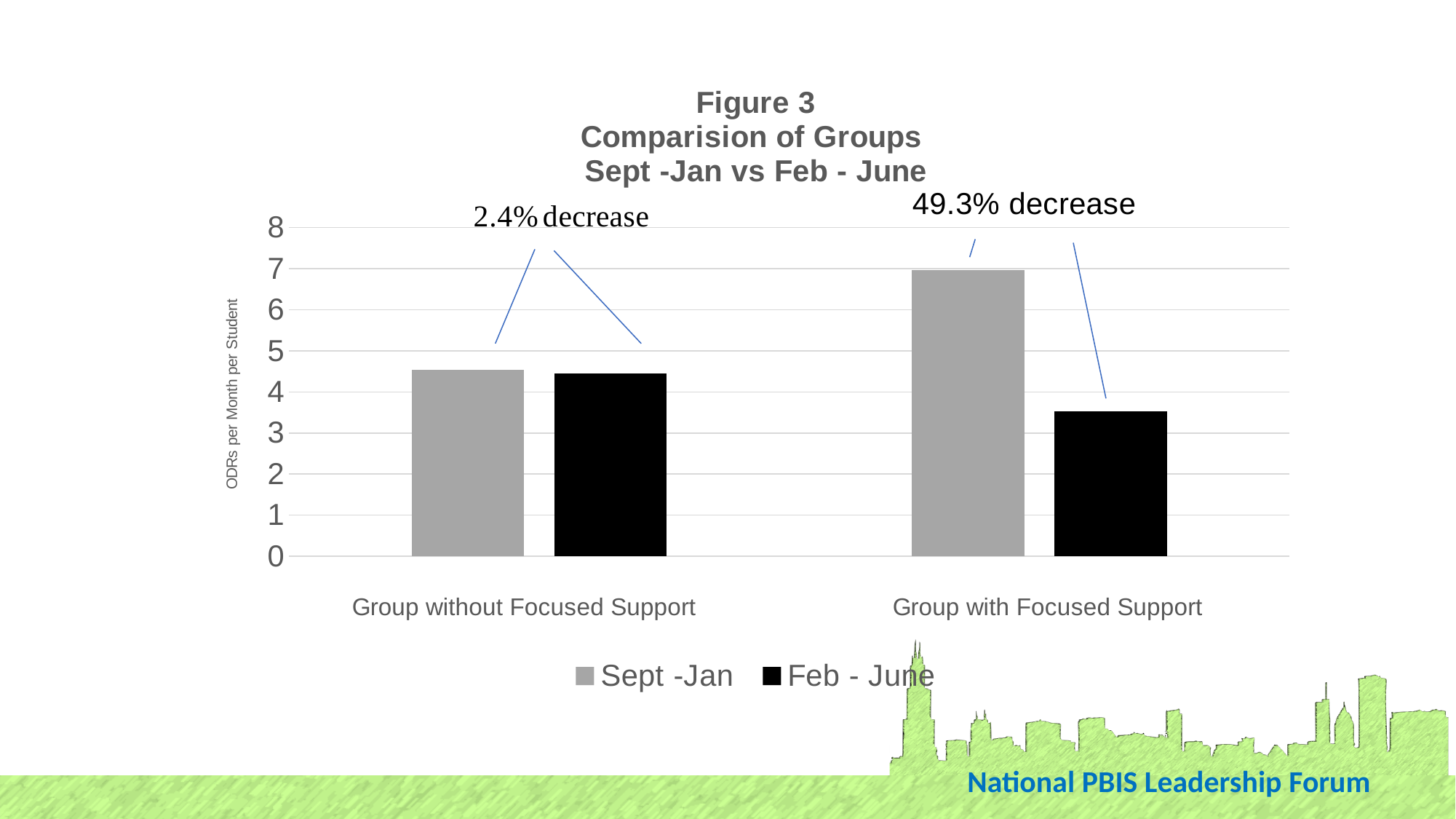
What percentage decrease is annotated for Group with Focused Support? 49.3% decrease What is the label on the y axis of the chart? ODRs per Month per Student Is the Sept -Jan value for Group with Focused Support greater or less than 6? greater Is the Sept -Jan value for Group without Focused Support greater or less than 5? less What kind of chart is shown on the slide? bar chart How many series does the legend list? 2 How many groups (categories) are shown on the x axis? 2 For the Feb - June series, which group has the larger value: Group without Focused Support or Group with Focused Support? Group without Focused Support For the Sept -Jan series, which group has the larger value: Group without Focused Support or Group with Focused Support? Group with Focused Support Which bar is the highest in the chart? Sept -Jan for Group with Focused Support Which bar is the lowest in the chart? Feb - June for Group with Focused Support Is the Feb - June value for Group with Focused Support greater or less than 4? less